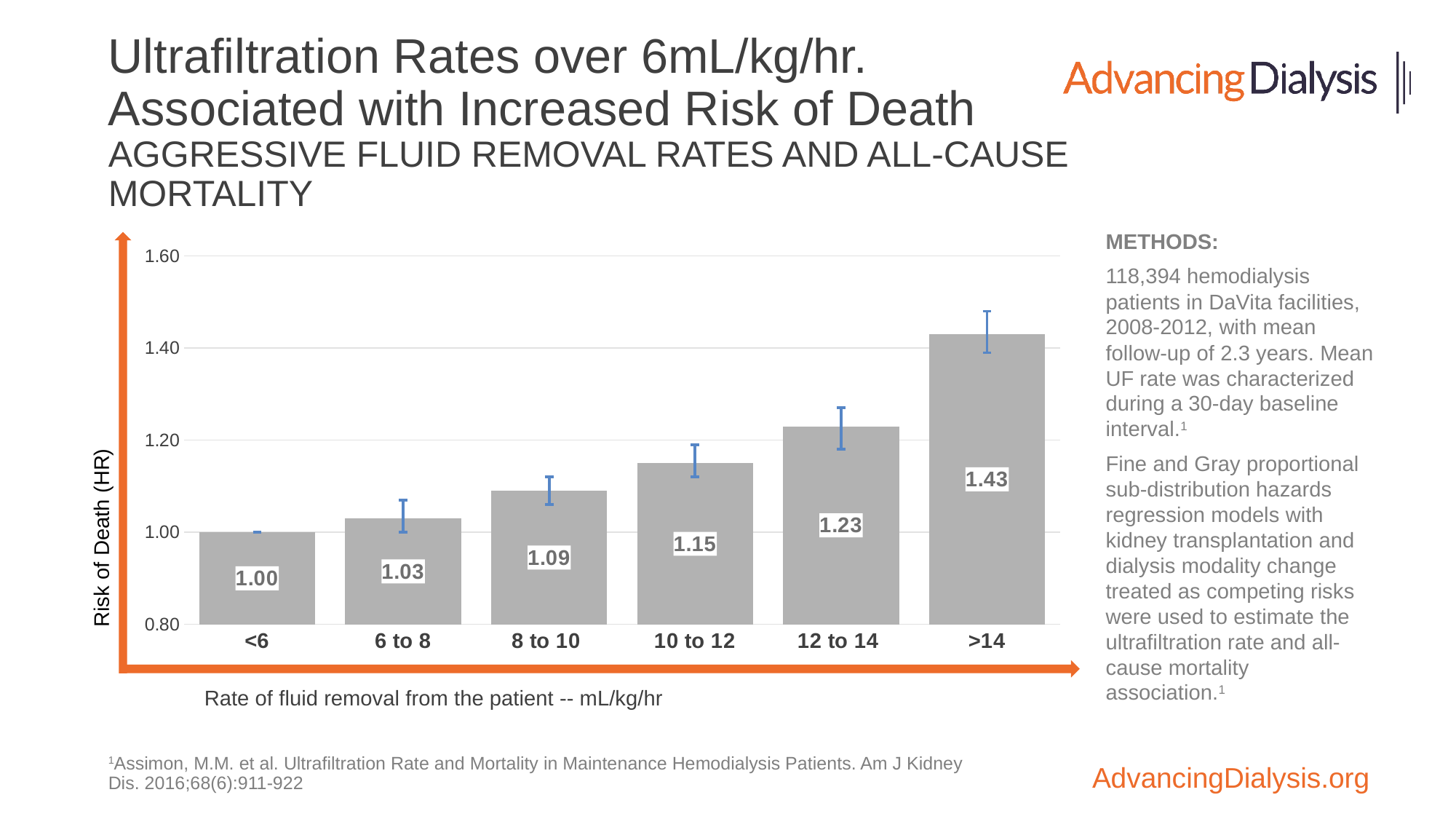
Is the risk of death (HR) for the >14 category greater or less than 1.40? greater Does the risk of death (HR) rise or fall as the rate of fluid removal increases along the x axis? Rises What is the risk of death (HR) for the 6 to 8 mL/kg/hr category? 1.03 What is the difference in risk of death (HR) between the >14 category and the <6 category? 0.43 Which has a higher risk of death (HR): the 8 to 10 category or the 12 to 14 category? 12 to 14 How many ultrafiltration rate categories are shown on the x axis? 6 What is the difference in risk of death (HR) between the 12 to 14 category and the 8 to 10 category? 0.14 What kind of chart is shown on the slide? Bar chart What is the risk of death (HR) for the >14 mL/kg/hr category? 1.43 Which ultrafiltration rate category has the lowest risk of death (HR)? <6 Which ultrafiltration rate category has the highest risk of death (HR)? >14 What is the risk of death (HR) for the 10 to 12 mL/kg/hr ultrafiltration rate category? 1.15